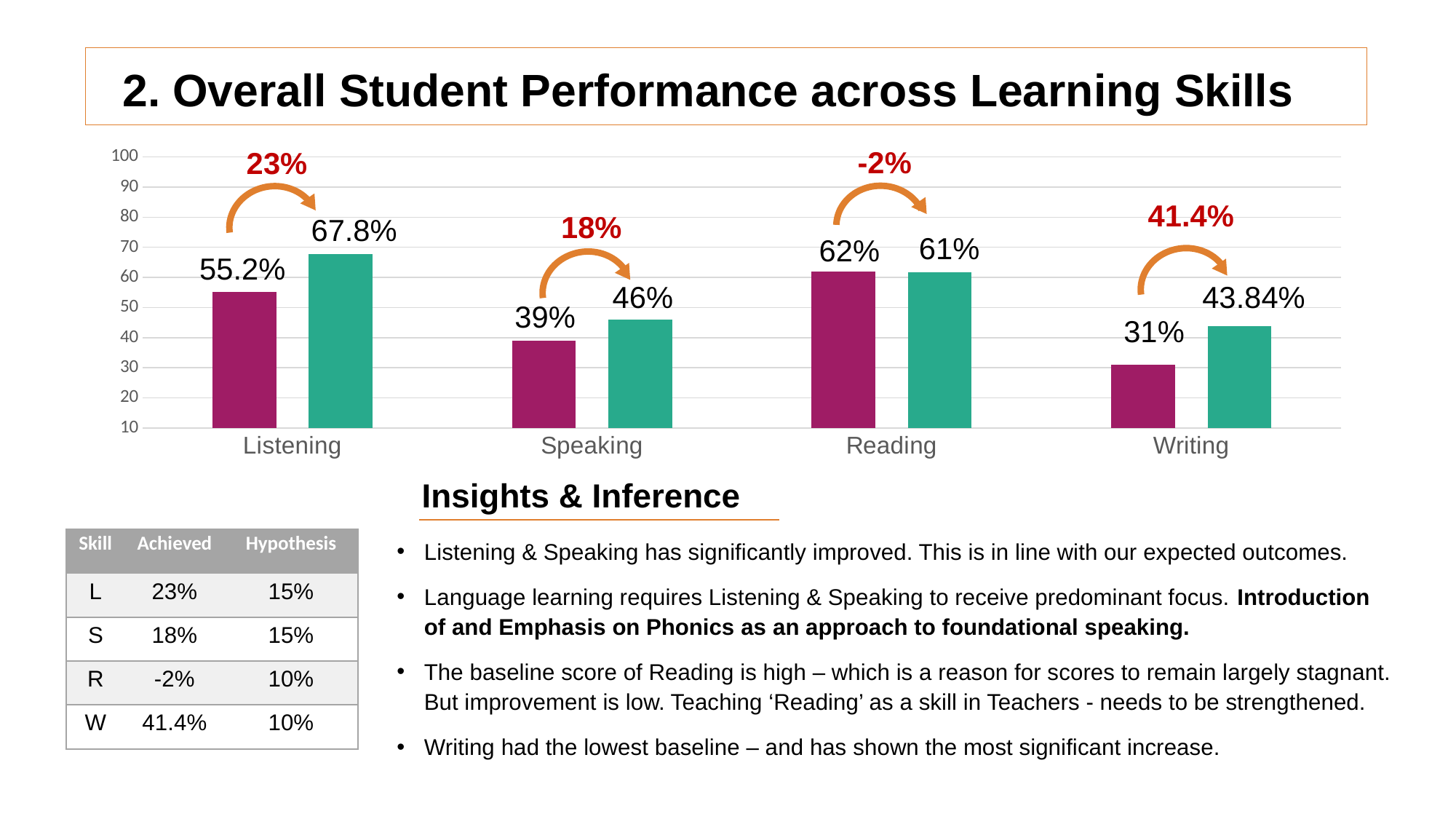
What kind of chart is shown on the slide? bar chart Which category has the highest value among the magenta (first) bars? Reading What percentage change is annotated above the Writing bars? 41.4% What is the value of the teal bar for Speaking? 46% What is the value of the second (teal) bar for Writing? 43.84% What is the value of the first (magenta) bar for Listening? 55.2% Which is larger for Reading: the magenta bar or the teal bar? the magenta bar How many categories are shown on the x axis of the chart? 4 Which category has the lowest value among the magenta (first) bars? Writing What is the value of the magenta bar for Reading? 62% Which category has the lowest value among the teal (second) bars? Writing What is the difference between the teal bar and the magenta bar for Listening? 12.6%